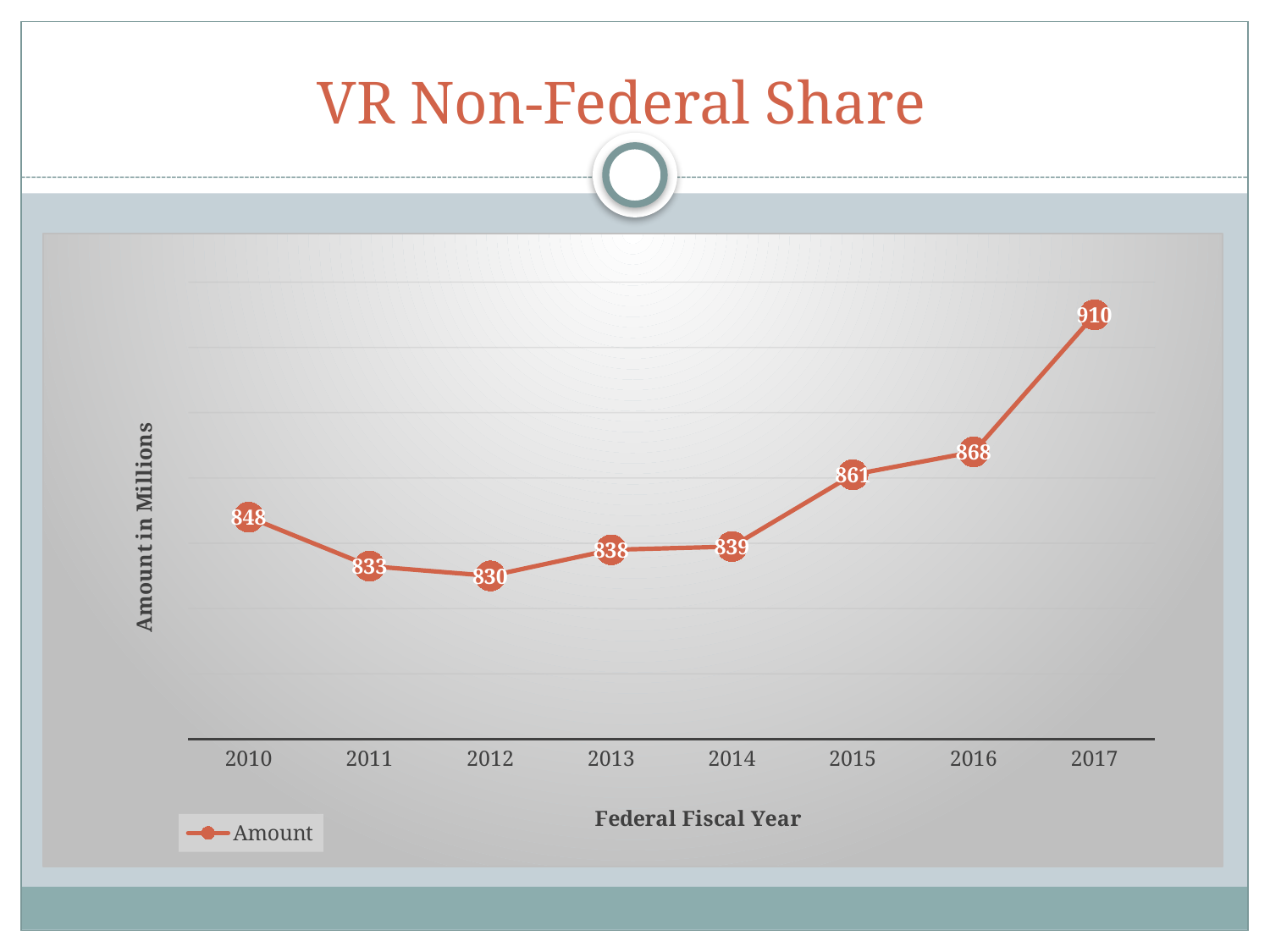
What is the Amount for 2017? 910 How many years are plotted on the x axis? 8 What kind of chart is shown on the slide? line chart What is the Amount for 2010? 848 What is the label of the y axis? Amount in Millions Which year has the highest Amount? 2017 Which is larger, the Amount for 2013 or the Amount for 2014? 2014 What is the difference between the Amount for 2010 and the Amount for 2011? 15 What is the Amount for 2015? 861 Which year has the lowest Amount? 2012 What is the difference between the Amount for 2017 and the Amount for 2016? 42 What is the Amount for 2012? 830